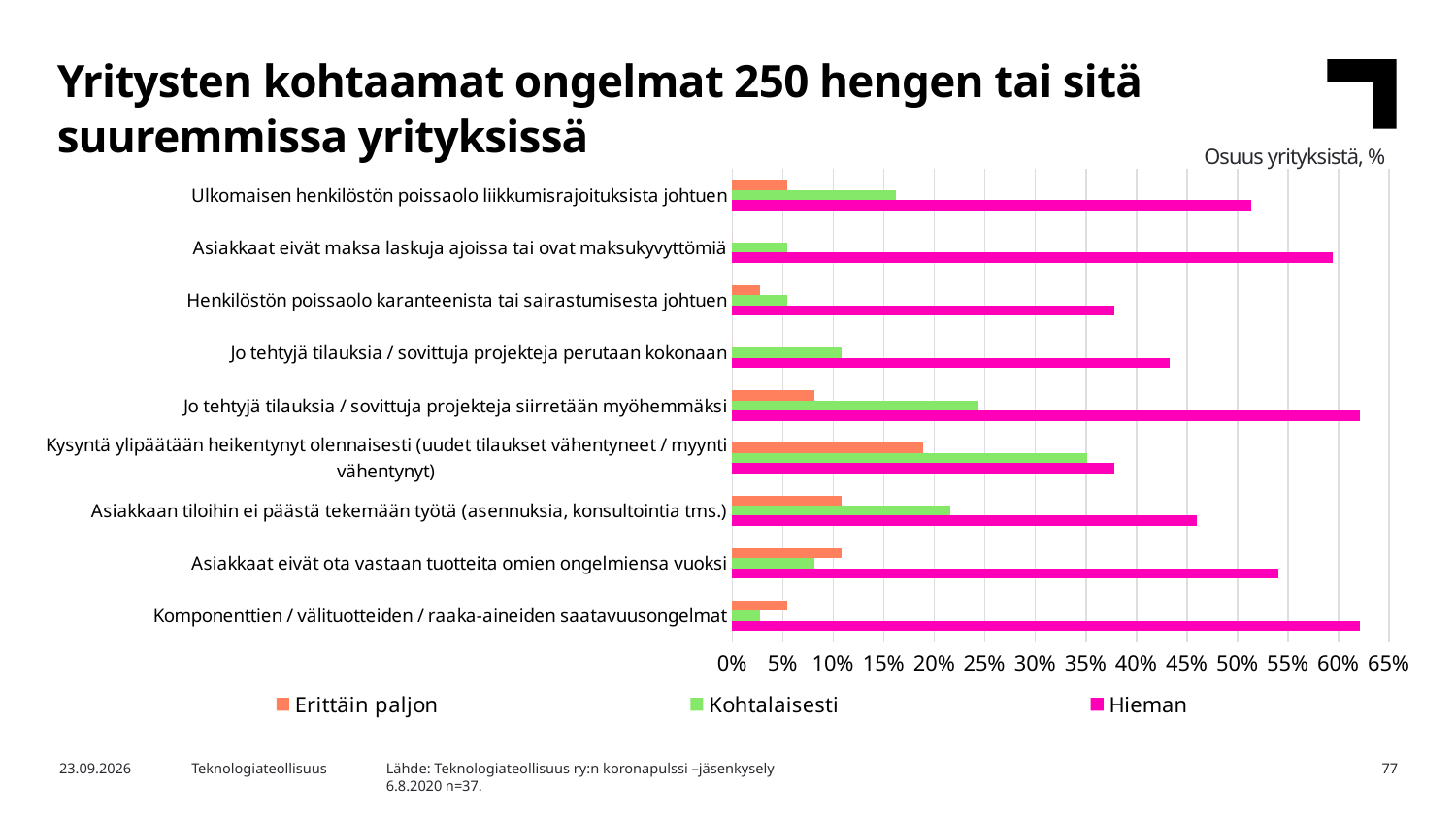
Is the 'Kohtalaisesti' value for 'Kysyntä ylipäätään heikentynyt olennaisesti' greater or less than 30%? greater How many categories (problem types) are listed on the chart? 9 What label is shown above the chart to indicate what the values represent? Osuus yrityksistä, % Which category has the highest value for the 'Erittäin paljon' series? Kysyntä ylipäätään heikentynyt olennaisesti (uudet tilaukset vähentyneet / myynti vähentynyt) Is the 'Hieman' value for 'Asiakkaat eivät maksa laskuja ajoissa tai ovat maksukyvyttömiä' greater or less than 55%? greater For the 'Kohtalaisesti' series, which is larger: 'Jo tehtyjä tilauksia / sovittuja projekteja siirretään myöhemmäksi' or 'Ulkomaisen henkilöstön poissaolo liikkumisrajoituksista johtuen'? Jo tehtyjä tilauksia / sovittuja projekteja siirretään myöhemmäksi For the 'Hieman' series, which is larger: 'Asiakkaat eivät ota vastaan tuotteita omien ongelmiensa vuoksi' or 'Asiakkaan tiloihin ei päästä tekemään työtä'? Asiakkaat eivät ota vastaan tuotteita omien ongelmiensa vuoksi How many series does the legend list? 3 Which category has the highest value for the 'Kohtalaisesti' series? Kysyntä ylipäätään heikentynyt olennaisesti (uudet tilaukset vähentyneet / myynti vähentynyt) What kind of chart is shown on the slide? Bar chart Which series does the magenta colour represent in the legend? Hieman Is the 'Hieman' value for 'Henkilöstön poissaolo karanteenista tai sairastumisesta johtuen' greater or less than 45%? less